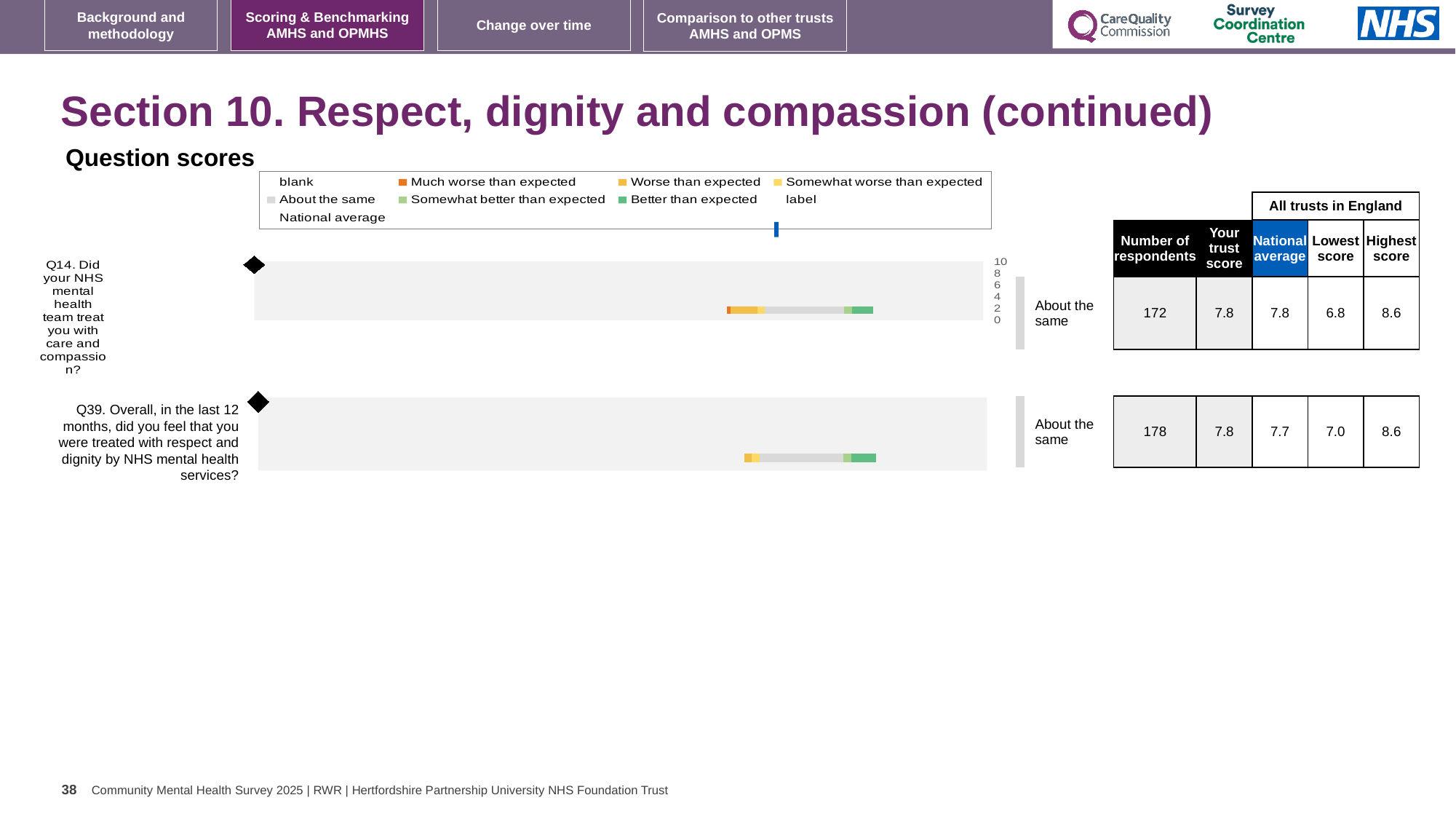
What kind of chart is used to show the question scores for Q14 and Q39? bar chart What is the highest score among all trusts in England for Q39? 8.6 What colour does the legend use for 'Better than expected'? green Which question has the higher lowest score across all trusts in England, Q14 or Q39? Q39 How many questions are plotted in the question scores charts? 2 What is the difference between the highest score and the lowest score for Q14? 1.8 What benchmark category label is shown next to the Q39 chart? About the same What is the lowest score among all trusts in England for Q14? 6.8 What is the 'Your trust score' for Q14 (care and compassion)? 7.8 How many respondents answered Q39? 178 Is the trust score for Q14 greater or less than 6 on the chart axis? greater What is the national average for Q39 (treated with respect and dignity)? 7.7